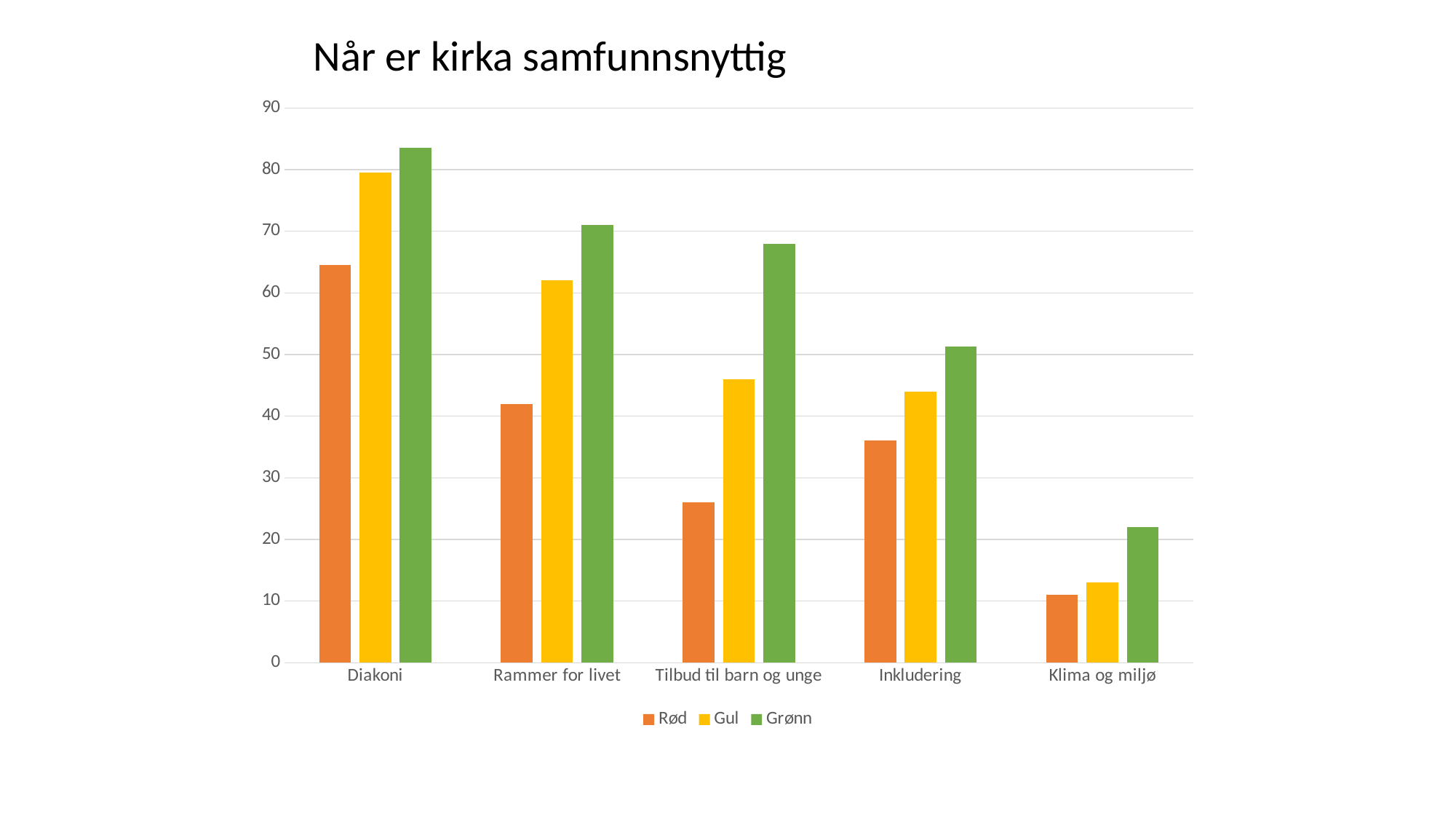
Which category has the lowest value for the Rød series? Klima og miljø Is the value for Rød in Tilbud til barn og unge greater or less than 30? less Which category has the highest value for the Grønn series? Diakoni Which is larger: the Gul value for Diakoni or the Gul value for Rammer for livet? Diakoni Is the value for Rød in Diakoni greater or less than 60? greater How many categories are shown on the x axis? 5 What is the title of the chart? Når er kirka samfunnsnyttig Is the value for Gul in Inkludering greater or less than 50? less How many series does the legend list? 3 What kind of chart is shown on the slide? bar chart Do the values for the Grønn series rise or fall from left to right along the x axis? fall